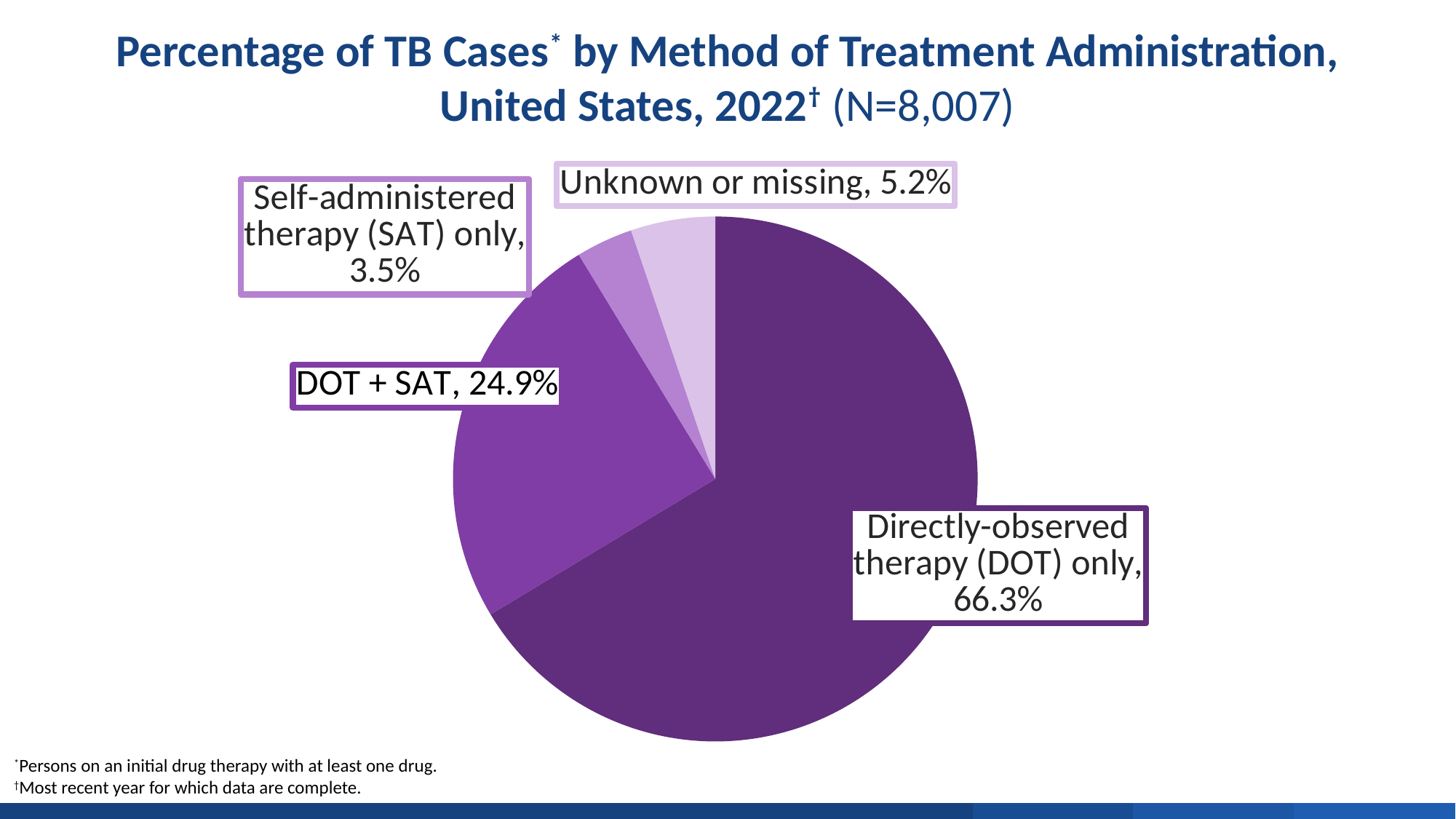
What is the total number of TB cases (N) stated in the chart title? 8,007 What percentage of TB cases were treated with self-administered therapy (SAT) only? 3.5% Which is larger: the share for Unknown or missing or the share for SAT only? Unknown or missing What percentage of TB cases were treated with DOT + SAT? 24.9% Which category accounts for the smallest share of TB cases? Self-administered therapy (SAT) only Which method of treatment administration accounts for the largest share of TB cases? Directly-observed therapy (DOT) only What percentage of TB cases were treated with directly-observed therapy (DOT) only? 66.3% How many slices does the pie chart have? 4 What is the difference in percentage points between DOT only and DOT + SAT? 41.4 What type of chart is shown on the slide? Pie chart What year does the chart title say the data are for? 2022 What percentage of TB cases have an unknown or missing method of treatment administration? 5.2%